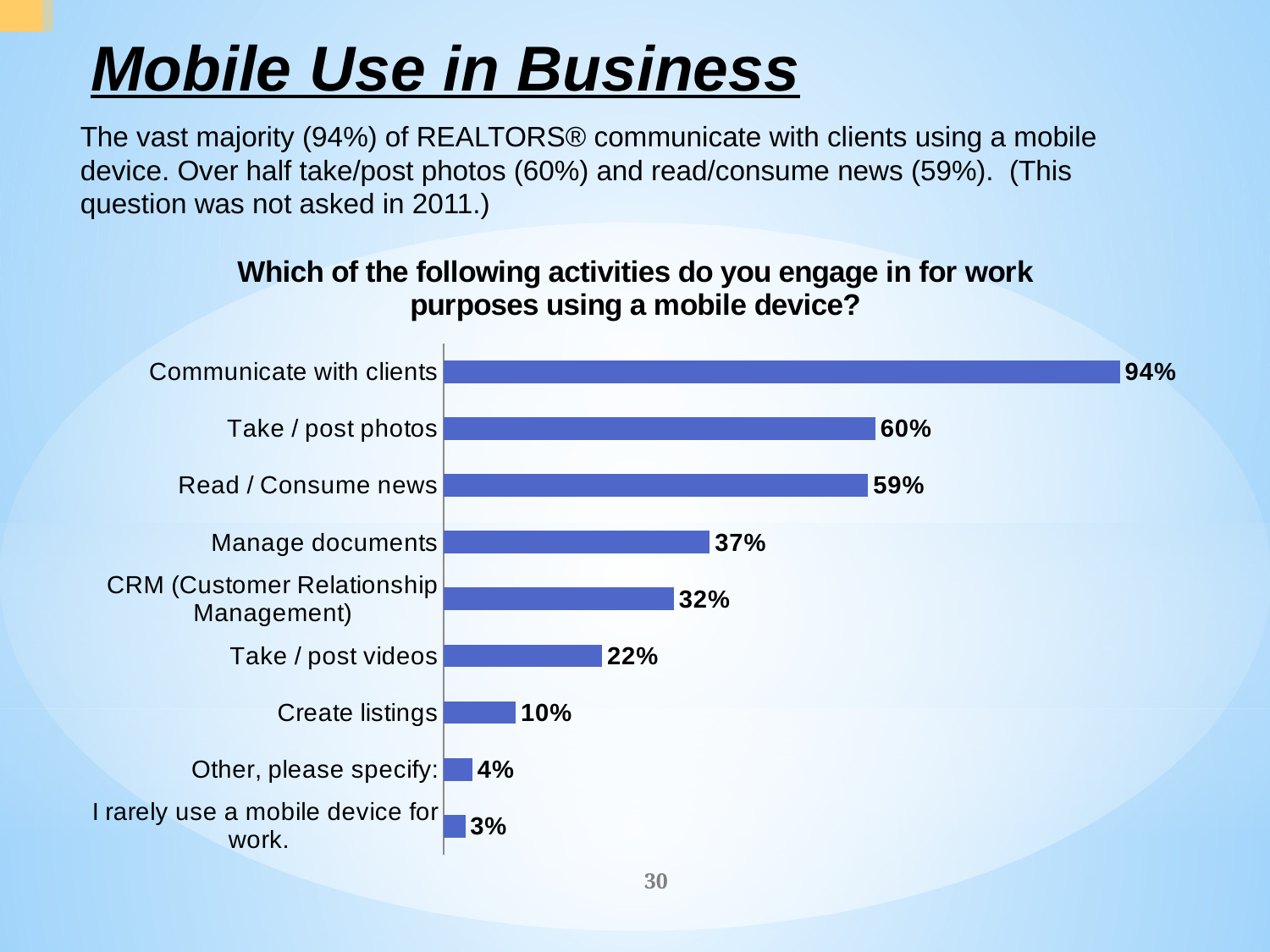
How many categories are shown in the chart? 9 Which activity has the highest percentage? Communicate with clients Which is larger, Manage documents or CRM (Customer Relationship Management)? Manage documents What is the value for CRM (Customer Relationship Management)? 32% Which category has the lowest percentage? I rarely use a mobile device for work. What is the value for Manage documents? 37% What is the title of the chart? Which of the following activities do you engage in for work purposes using a mobile device? What kind of chart is shown on the slide? Bar chart What is the difference between Take / post photos and Take / post videos? 38% What percentage of respondents communicate with clients using a mobile device? 94% What is the difference between Communicate with clients and Read / Consume news? 35% What is the value for Create listings? 10%